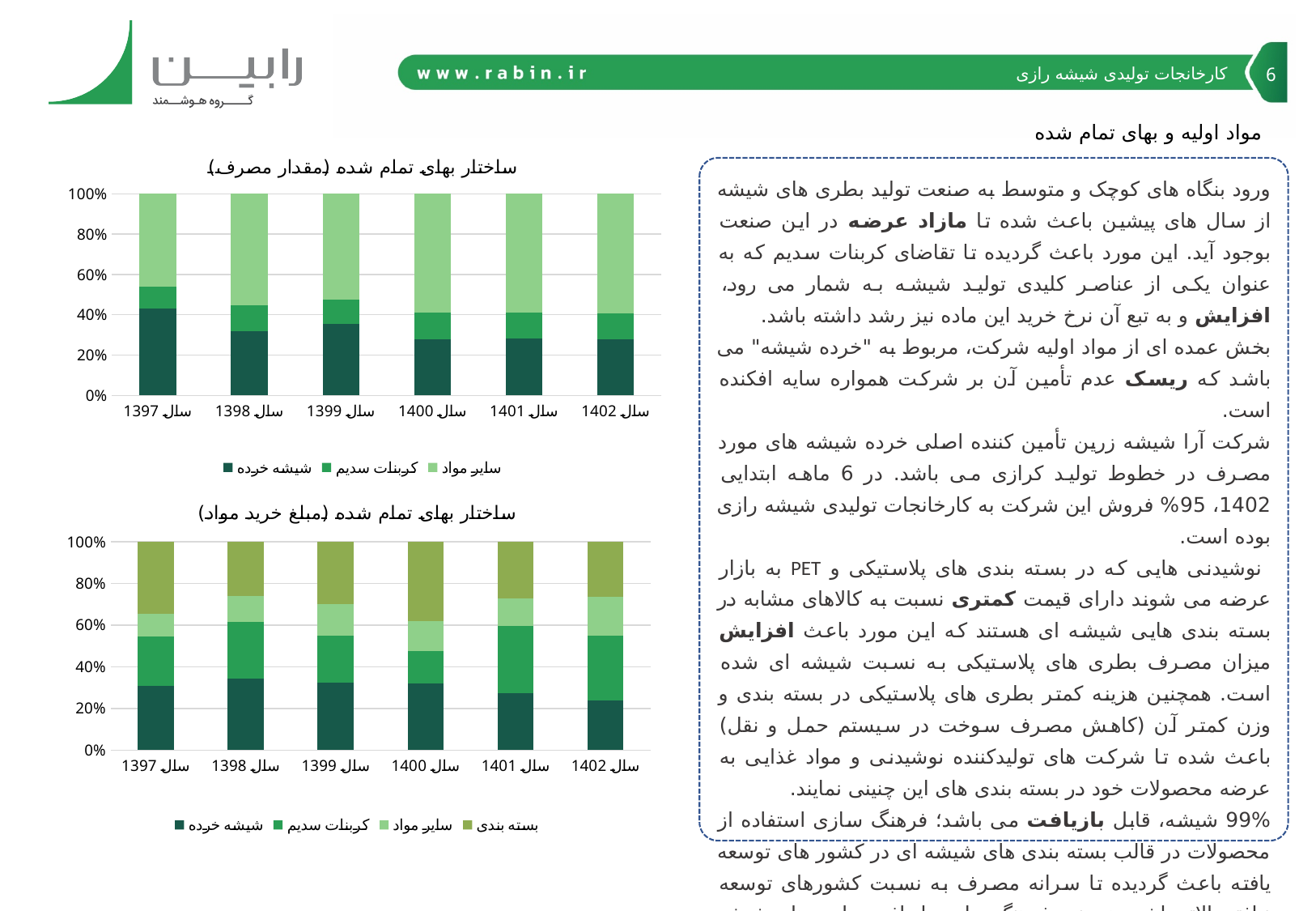
How many series does the legend of the bottom chart "ساختار بهای تمام شده (مبلغ خرید مواد)" list? 4 How many series does the legend of the top chart "ساختار بهای تمام شده (مقدار مصرف)" list? 3 In the top chart "ساختار بهای تمام شده (مقدار مصرف)", is the share of شیشه خرده in سال 1397 greater or less than 40%? greater In the bottom chart "ساختار بهای تمام شده (مبلغ خرید مواد)", is the share of شیشه خرده in سال 1402 greater or less than 40%? less In the top chart "ساختار بهای تمام شده (مقدار مصرف)", is the share of شیشه خرده in سال 1400 greater or less than 40%? less How many years (categories) are shown on the x axis of the top chart "ساختار بهای تمام شده (مقدار مصرف)"? 6 Which series appears in the legend of the bottom chart "ساختار بهای تمام شده (مبلغ خرید مواد)" but not in the legend of the top chart? بسته بندی In the bottom chart "ساختار بهای تمام شده (مبلغ خرید مواد)", which year has the smallest share for شیشه خرده? سال 1402 In the top chart "ساختار بهای تمام شده (مقدار مصرف)", which year has the largest share for شیشه خرده? سال 1397 What type of chart is the top chart titled "ساختار بهای تمام شده (مقدار مصرف)"? Stacked bar chart In the top chart "ساختار بهای تمام شده (مقدار مصرف)", which is larger: the share of شیشه خرده in سال 1397 or in سال 1398? سال 1397 In the bottom chart "ساختار بهای تمام شده (مبلغ خرید مواد)", what does each stacked bar total? 100%